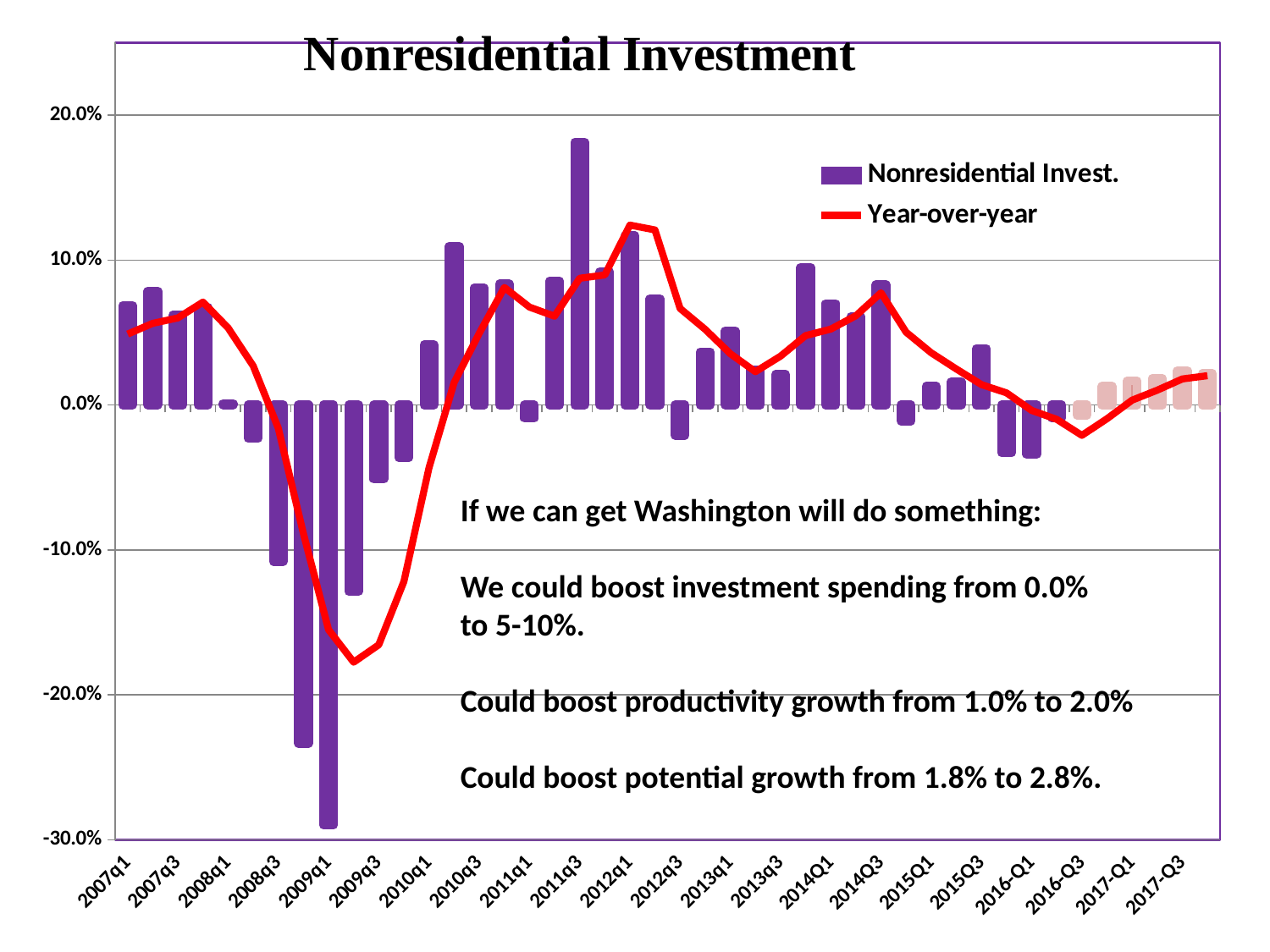
Is the Nonresidential Invest. value for 2011q3 greater or less than 10.0%? greater Which quarter has the lowest Nonresidential Invest. bar? 2009q1 Which series is drawn as a red line? Year-over-year Is the Year-over-year value for 2012q1 greater or less than 10.0%? greater What kind of chart is shown on the slide? A combined bar and line chart What is the title of the chart? Nonresidential Investment Which quarter has the highest Nonresidential Invest. bar? 2011q3 How many series does the legend list? 2 Is the Year-over-year value for 2009q1 greater or less than -10.0%? less Does the Year-over-year line rise or fall from 2009q1 to 2010q3? rise Do the Nonresidential Invest. bars rise or fall from 2007q1 to 2009q1? fall